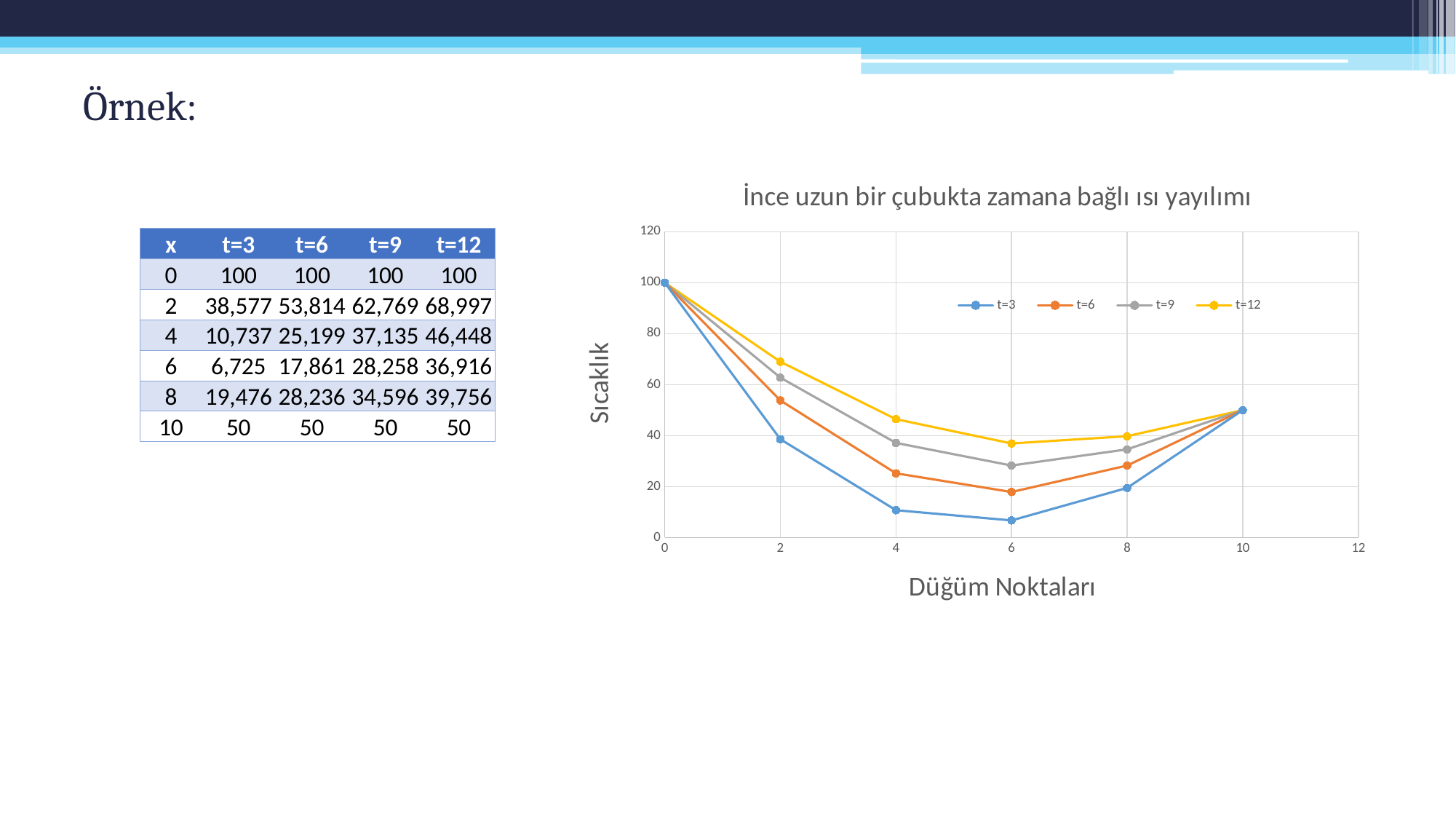
Is the value of the t=12 series at x=2 greater or less than 60? greater What kind of chart is shown on the slide? line chart Is the value of the t=3 series at x=6 greater or less than 20? less What is the value of the t=12 series at x=6? 36,916 What is the title of the chart? İnce uzun bir çubukta zamana bağlı ısı yayılımı Does the t=3 series rise or fall from x=0 to x=6? fall What is the value of the t=3 series at x=2? 38,577 At which x value does the t=3 series reach its lowest point? 6 How many series does the chart legend list? 4 What is the difference between the t=12 and t=3 values at x=8? 20,280 At x=4, which series has the larger value, t=3 or t=12? t=12 How many data points does the t=3 series have? 6